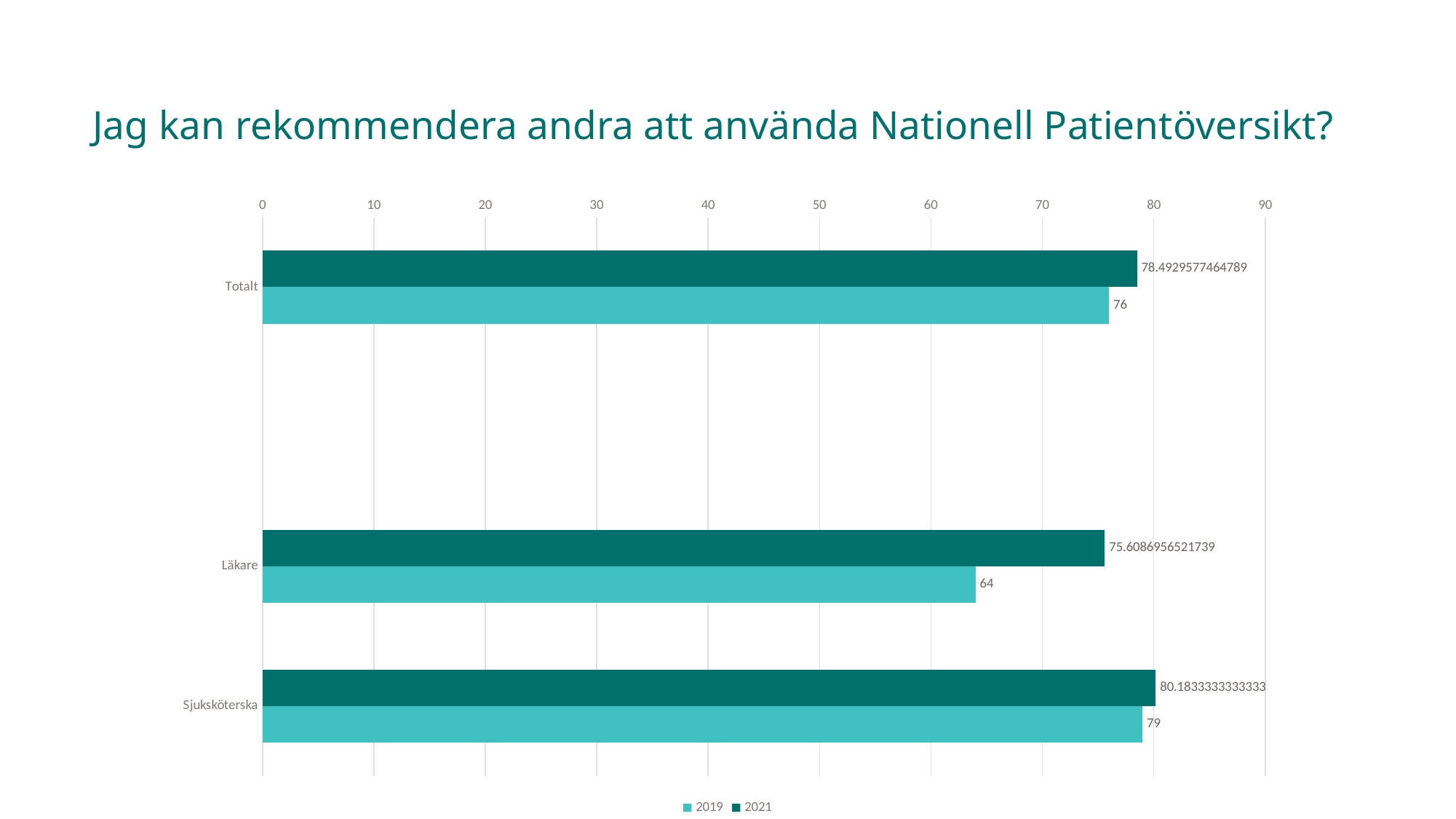
How many series does the legend list? 2 Which category has the highest 2019 value? Sjuksköterska Which is larger for Läkare, the 2019 value or the 2021 value? 2021 How many categories are shown on the chart? 3 What is the 2021 value for Läkare? 75.6086956521739 What kind of chart is shown on the slide? Bar chart Which category has the lowest 2021 value? Läkare Which category has the lowest 2019 value? Läkare What is the difference between the 2019 values for Sjuksköterska and Läkare? 15 What is the 2019 value for Totalt? 76 What is the 2019 value for Läkare? 64 What is the 2021 value for Sjuksköterska? 80.1833333333333